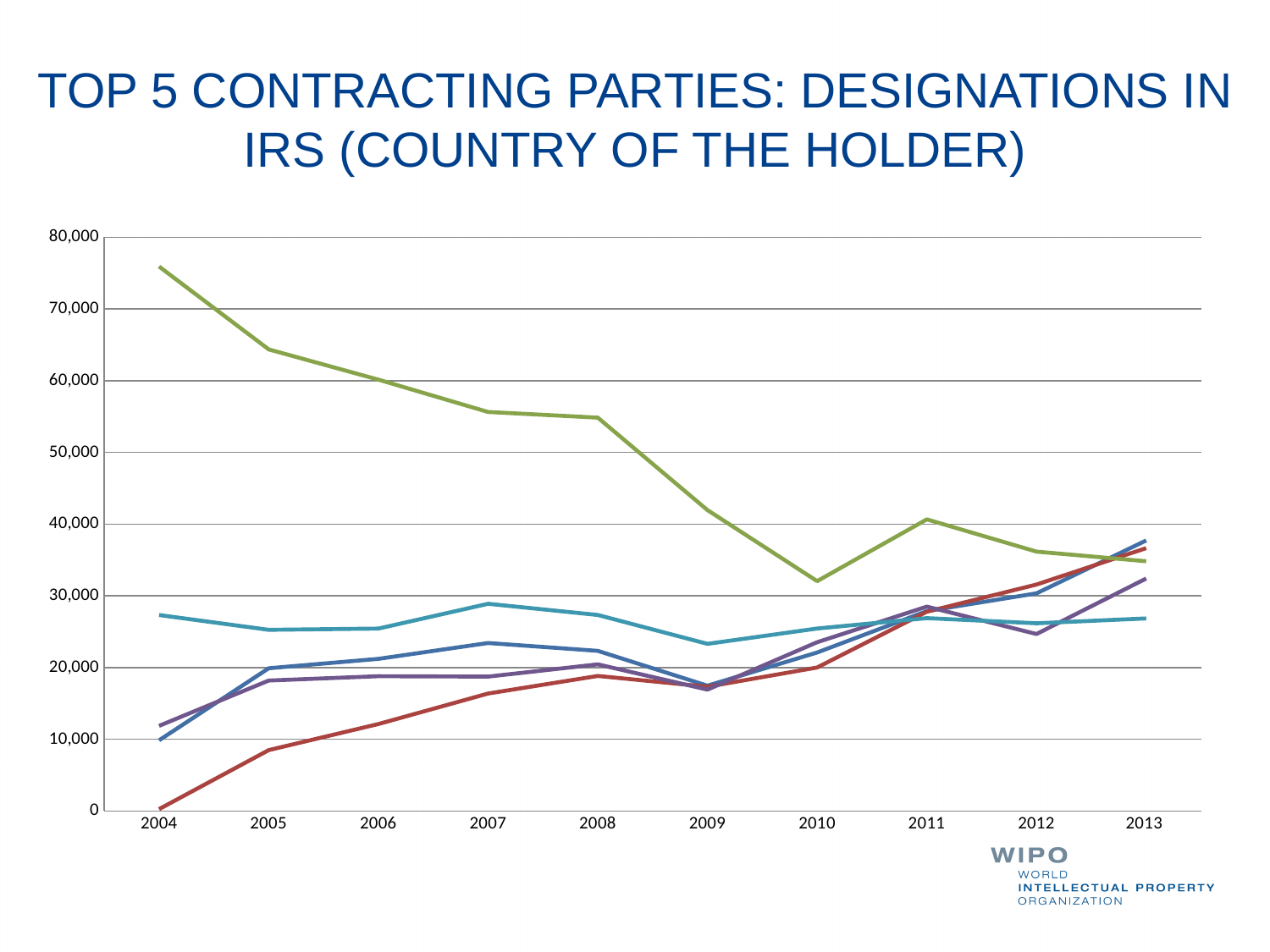
Is the value of the green line in 2008 greater or less than 50,000? greater Is the value of the red line in 2005 greater or less than 10,000? less Is the value of the purple line in 2012 greater or less than 30,000? less Which line has the lowest value in 2004? the red line In 2013, which is larger: the value of the green line or the value of the light blue (teal) line? the green line Does the green line rise or fall between 2004 and 2010? fall How many lines are plotted on the chart? 5 How many years are shown along the x axis of the chart? 10 What kind of chart is shown on the slide? line chart Which line has the highest value in 2004? the green line What is the title of the chart on the slide? TOP 5 CONTRACTING PARTIES: DESIGNATIONS IN IRS (COUNTRY OF THE HOLDER)